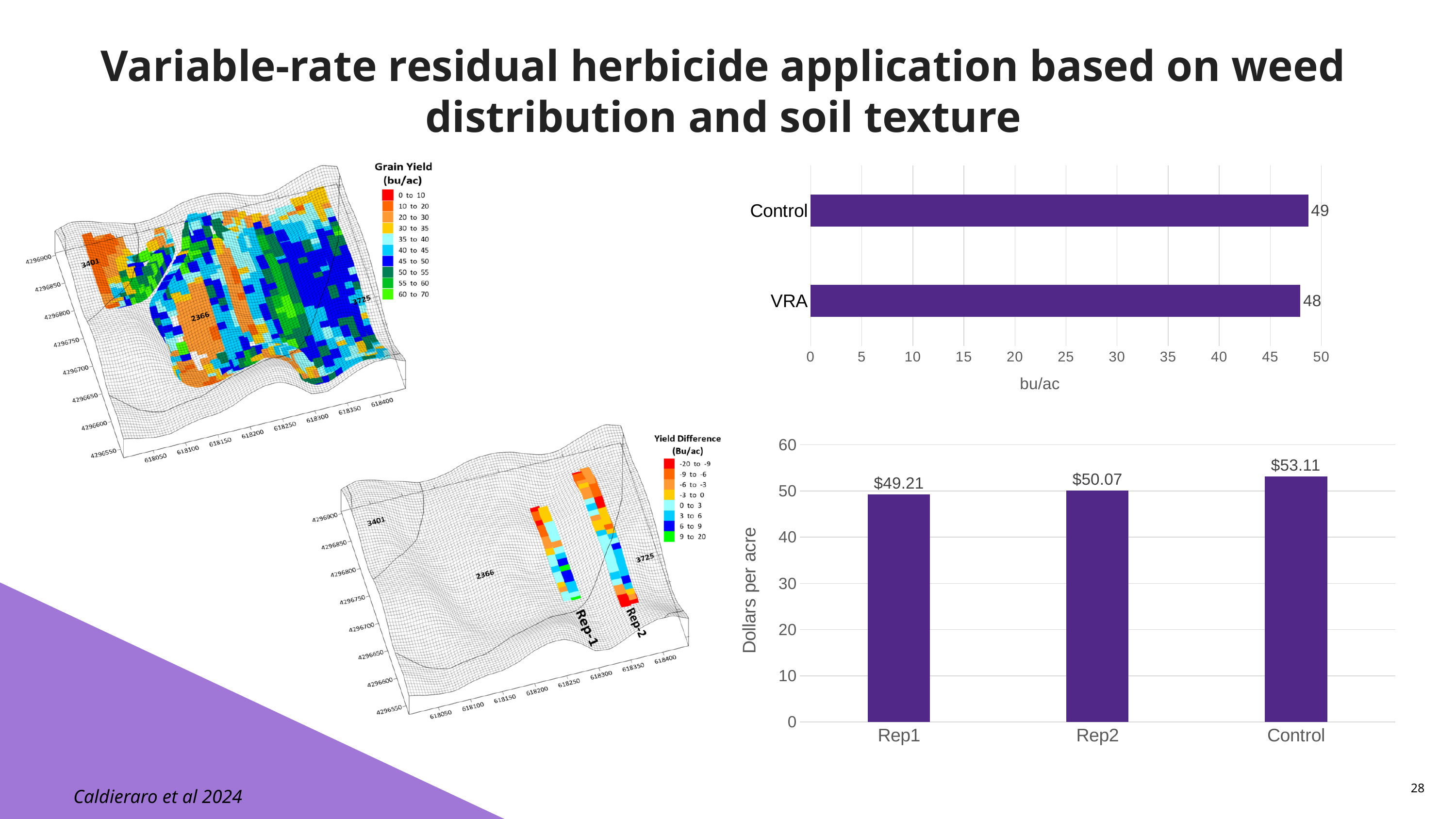
In the top-right bar chart (bu/ac), what is the value for Control? 49 In the top-right bar chart (bu/ac), which category has the higher value, Control or VRA? Control In the bottom-right chart (Dollars per acre), which category has the highest value? Control In the bottom-right chart (Dollars per acre), what is the value for Rep2? $50.07 In the bottom-right chart (Dollars per acre), what is the value for Rep1? $49.21 In the bottom-right chart (Dollars per acre), what is the value for Control? $53.11 In the top-right bar chart (bu/ac), what is the difference between the Control and VRA values? 1 In the bottom-right chart (Dollars per acre), which category has the lowest value? Rep1 In the top-right bar chart (bu/ac), what is the value for VRA? 48 In the top-right bar chart (bu/ac), how many categories are plotted? 2 In the bottom-right chart (Dollars per acre), what is the difference between the Control and Rep1 values? $3.90 What kind of chart is the top-right chart with the bu/ac axis? bar chart